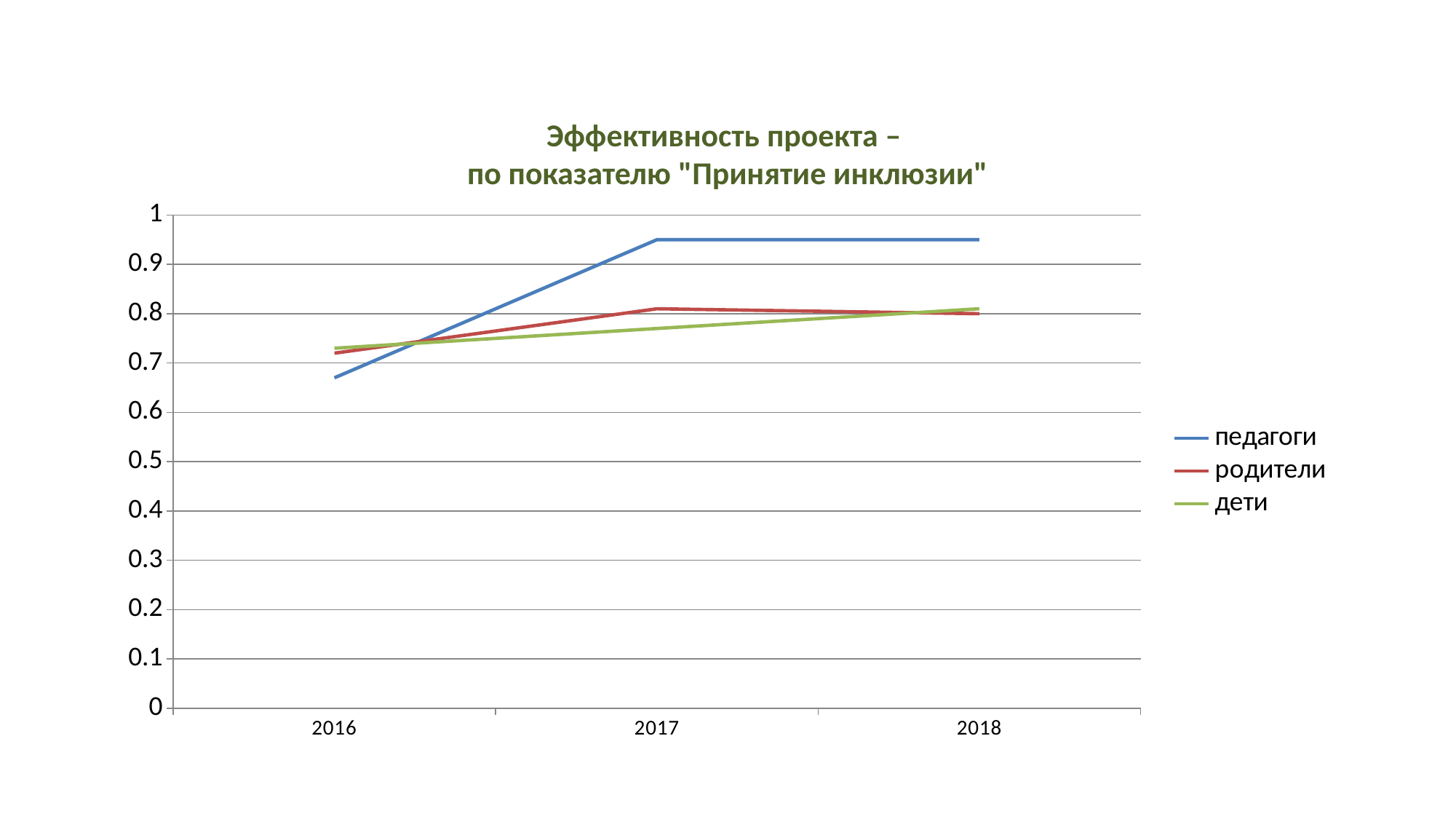
How many years are shown on the x axis? 3 Which series has the highest value in 2018? педагоги In 2017, which is larger: the value for педагоги or the value for родители? педагоги What colour is the line for педагоги? blue Which series has the lowest value in 2016? педагоги How many series does the legend list? 3 What kind of chart is shown on the slide? line chart Is the value for педагоги in 2017 greater or less than 0.9? greater Is the value for родители in 2016 greater or less than 0.7? greater Does the value for педагоги rise or fall from 2016 to 2017? rise Is the value for дети in 2017 greater or less than 0.8? less